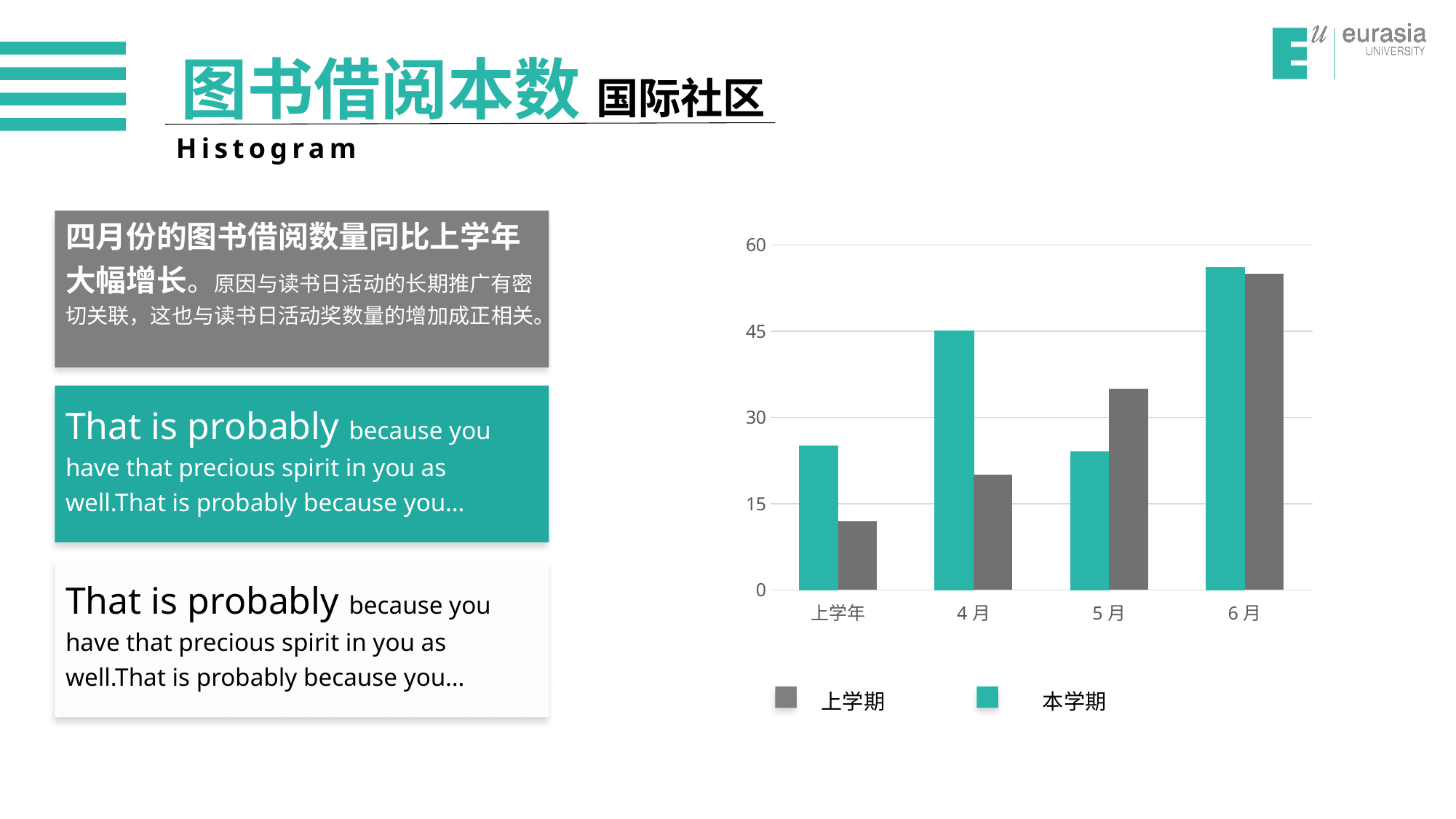
What kind of chart is shown on the slide? bar chart Which category has the highest value for the 本学期 series? 6 月 Which category has the lowest value for the 上学期 series? 上学年 In 4 月, which series has the larger value, 上学期 or 本学期? 本学期 Is the 上学期 value for 上学年 greater or less than 15? less Is the 上学期 value for 5 月 greater or less than 30? greater Which category has the highest value for the 上学期 series? 6 月 How many series does the chart's legend list? 2 Is the 本学期 value for 6 月 greater or less than 45? greater In 5 月, which series has the larger value, 上学期 or 本学期? 上学期 How many categories are shown on the x axis of the chart? 4 What colour represents the 本学期 series in the chart? teal